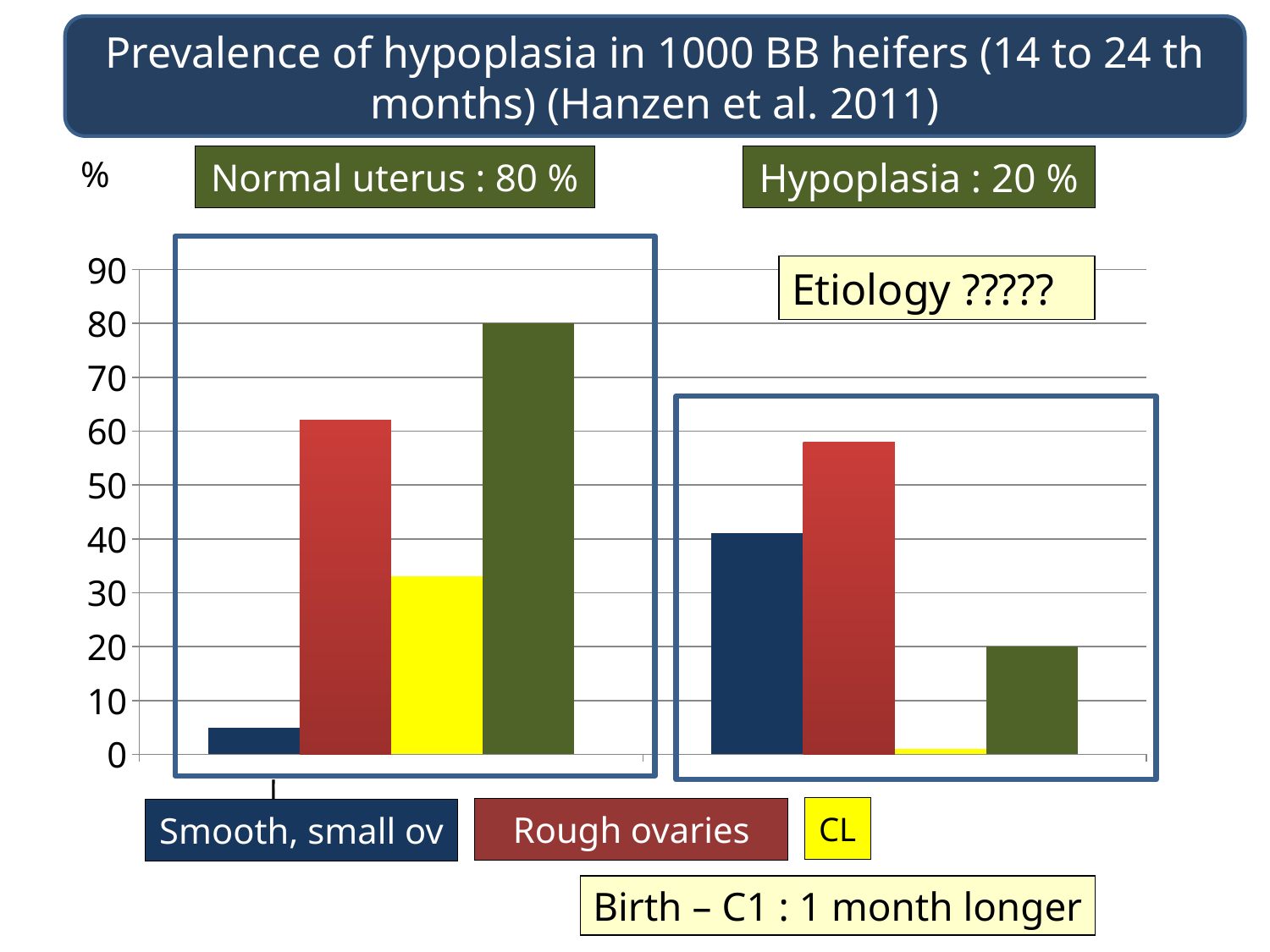
In the normal uterus group, is the value for Rough ovaries greater or less than 50? greater What is the difference in percentage points between the normal uterus group and the hypoplasia group? 60 In the hypoplasia group, is the value for Smooth, small ovaries greater or less than 30? greater In the normal uterus group, which is larger: Rough ovaries or Smooth, small ovaries? Rough ovaries How many groups of bars are shown in the chart? 2 What percentage of the heifers had a normal uterus? 80 % How many entries does the legend below the chart list? 3 In the normal uterus group, is the value for Smooth, small ovaries greater or less than 10? less In the hypoplasia group, which legend category has the lowest bar? CL What kind of chart is shown on the slide? bar chart What percentage of the heifers had hypoplasia? 20 %